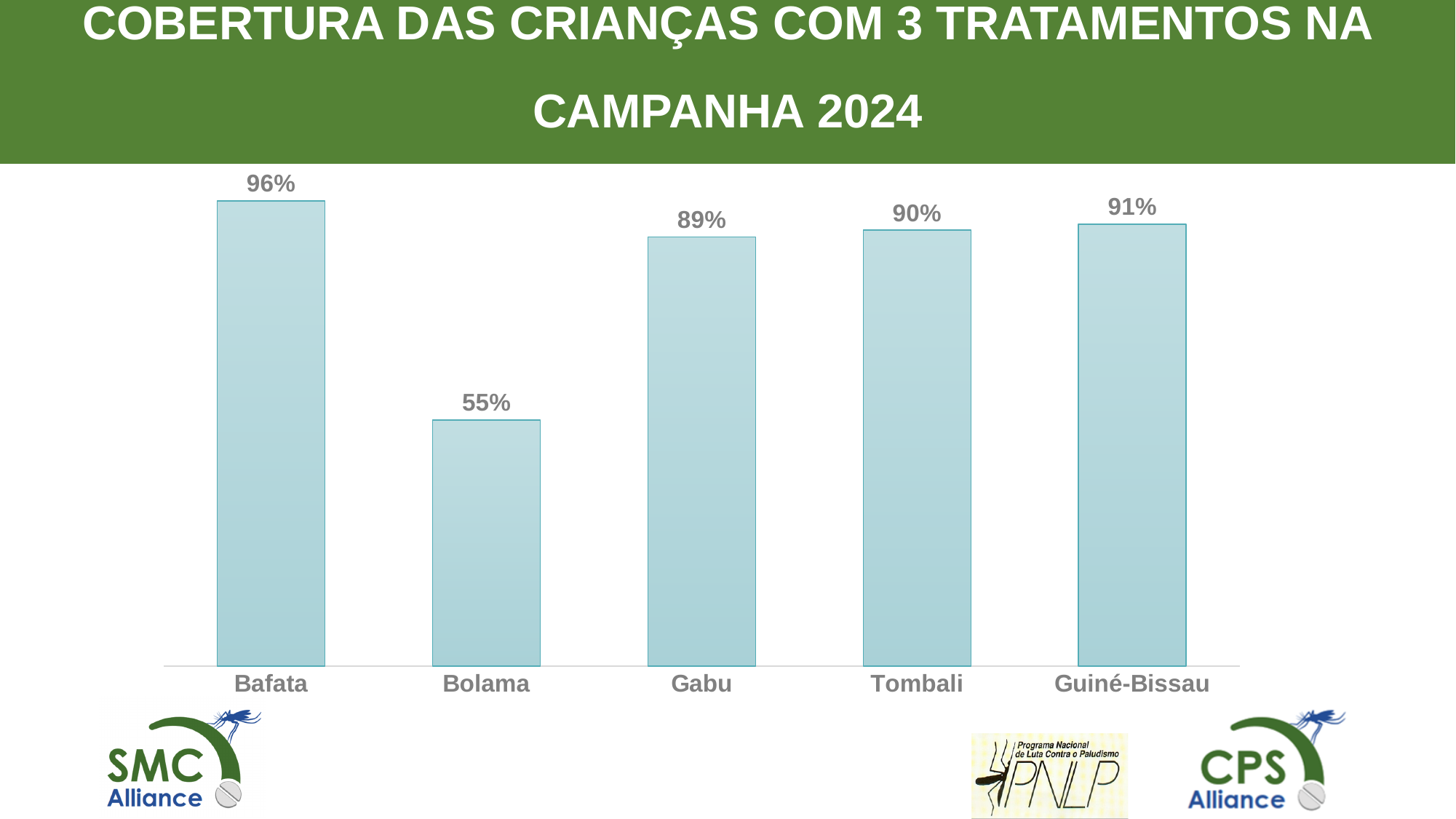
What is the coverage value for Bafata? 96% What is the difference between the coverage for Bafata and Bolama? 41% Which has a higher coverage, Gabu or Bolama? Gabu What is the coverage value for Guiné-Bissau? 91% What is the coverage value for Bolama? 55% Which category has the highest coverage? Bafata What is the coverage value for Gabu? 89% How many categories are shown in the chart? 5 What is the difference between the coverage for Guiné-Bissau and Gabu? 2% What kind of chart is shown on the slide? Bar chart Which category has the lowest coverage? Bolama What is the coverage value for Tombali? 90%